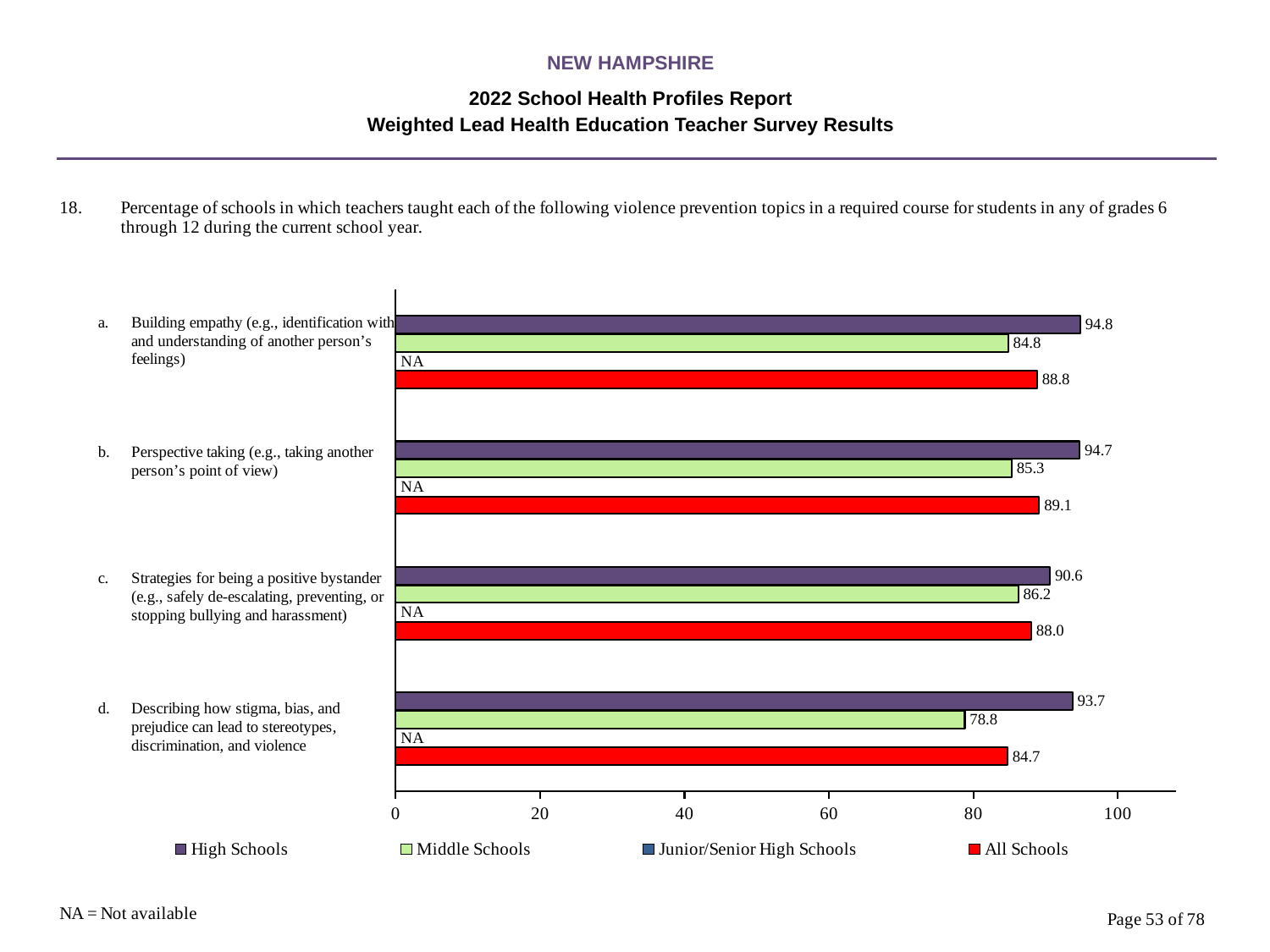
What is the value for All Schools for topic c, strategies for being a positive bystander? 88.0 What colour are the All Schools bars? Red Which topic has the lowest value for Middle Schools? Describing how stigma, bias, and prejudice can lead to stereotypes, discrimination, and violence (d) Which is larger for topic c: the High Schools value or the All Schools value? High Schools What kind of chart is shown on the slide? Bar chart Which topic has the highest value for High Schools? Building empathy (a) What is the value for Middle Schools for topic d, describing how stigma, bias, and prejudice can lead to stereotypes, discrimination, and violence? 78.8 What is the value for High Schools for topic a, building empathy? 94.8 What is the value for Junior/Senior High Schools for topic b, perspective taking? NA How many topics (categories) are shown on the chart? 4 How many series does the legend list? 4 What is the difference between the High Schools and Middle Schools values for topic d? 14.9